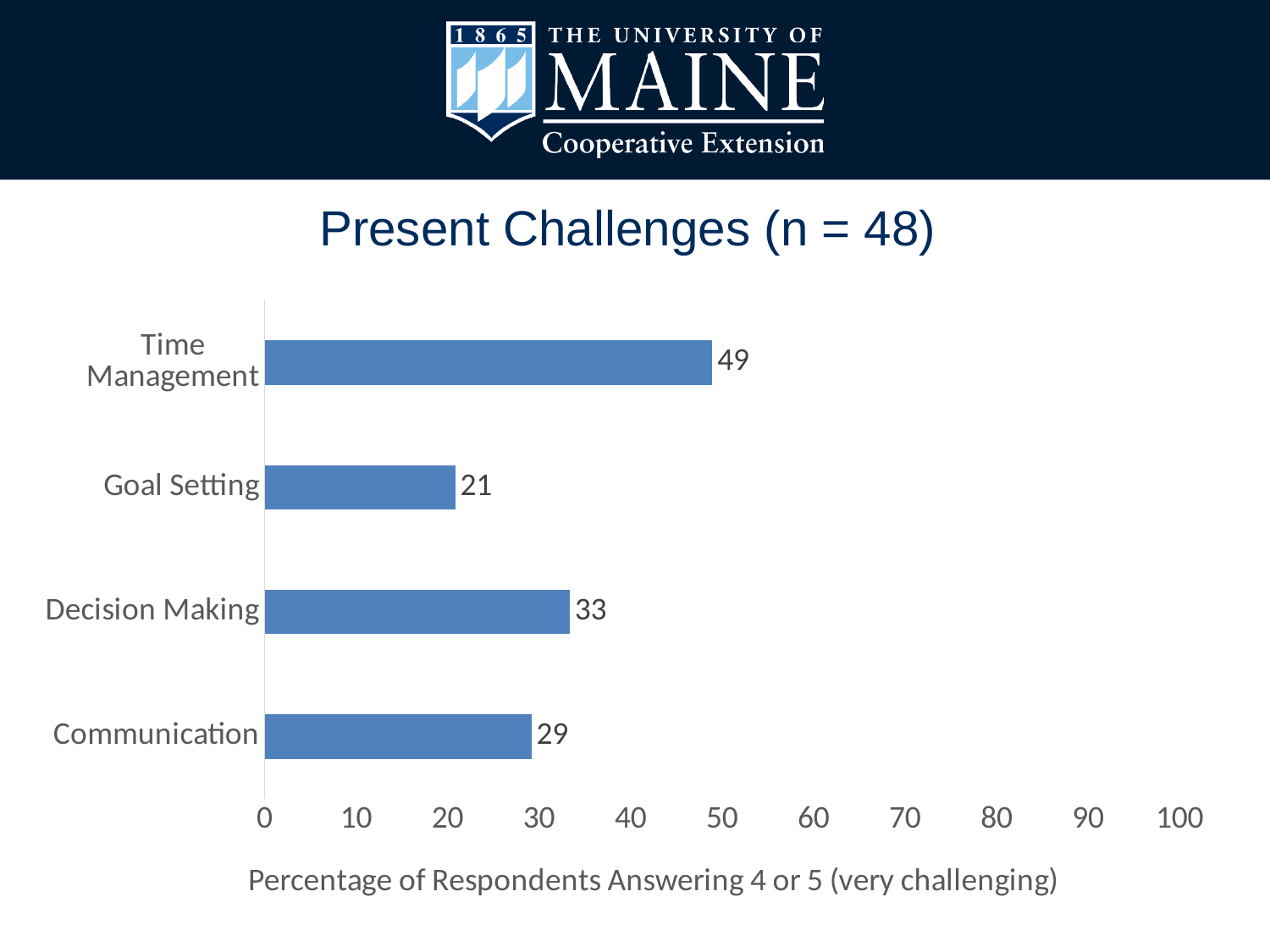
What is the value for Communication? 29 Is the value for Time Management greater or less than 40? greater What is the value for Decision Making? 33 How many categories are shown in the chart? 4 Which is larger, the value for Decision Making or the value for Communication? Decision Making What kind of chart is shown on the slide? bar chart What is the difference between the values for Time Management and Goal Setting? 28 Which category has the highest value? Time Management What is the value for Goal Setting? 21 What is the difference between the values for Decision Making and Communication? 4 What is the value for Time Management? 49 Which category has the lowest value? Goal Setting